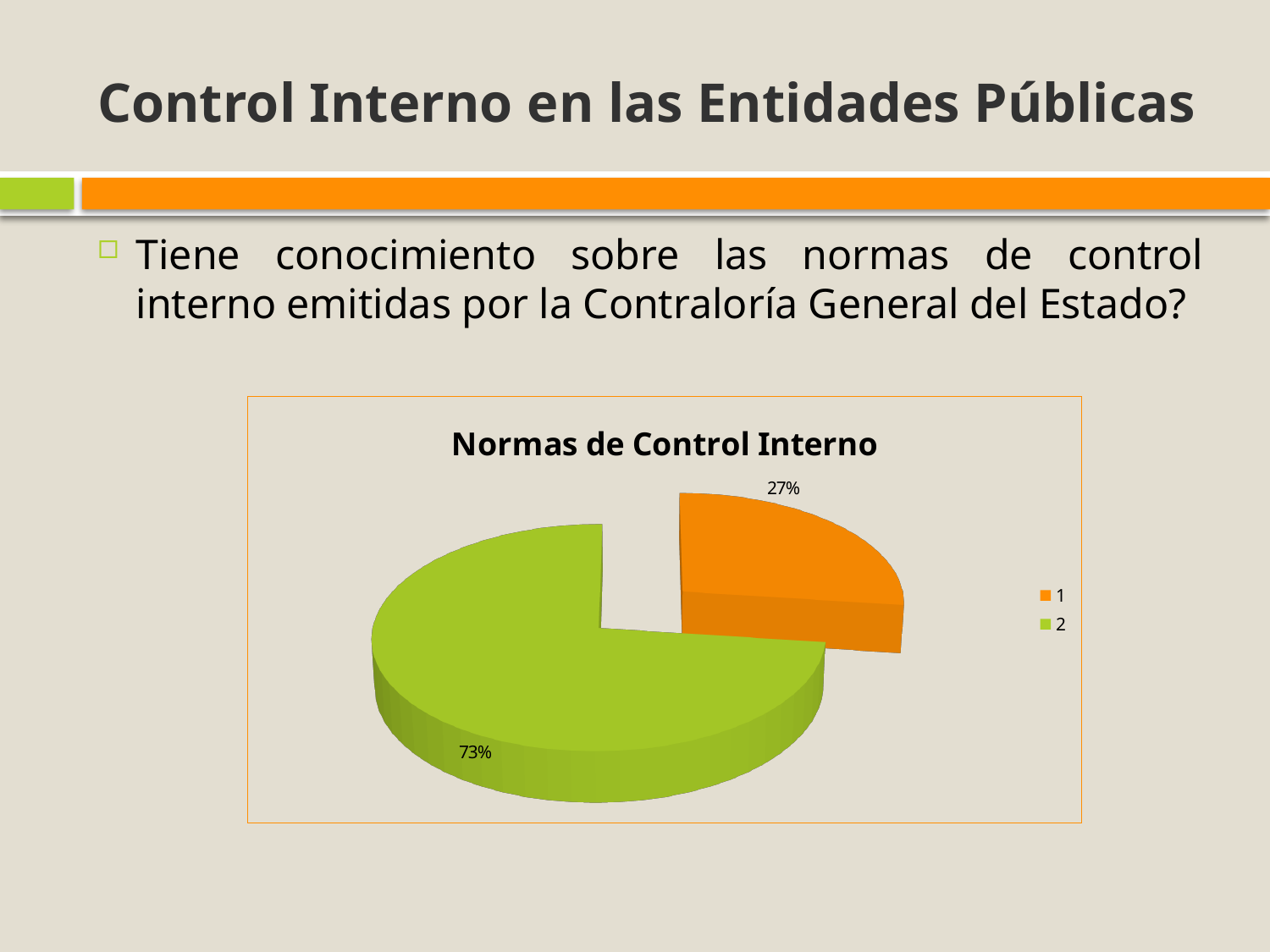
What colour is slice 1? orange What is the title of the chart? Normas de Control Interno How many entries does the legend list? 2 How many slices does the pie chart have? 2 What percentage does slice 2 represent? 73% What share of the pie does slice 2 take? 73% What percentage does slice 1 represent? 27% Which is larger, slice 1 or slice 2? 2 What kind of chart is shown on the slide? pie chart Which slice is the largest? 2 What is the difference in percentage points between slice 2 and slice 1? 46 Which slice is the smallest? 1